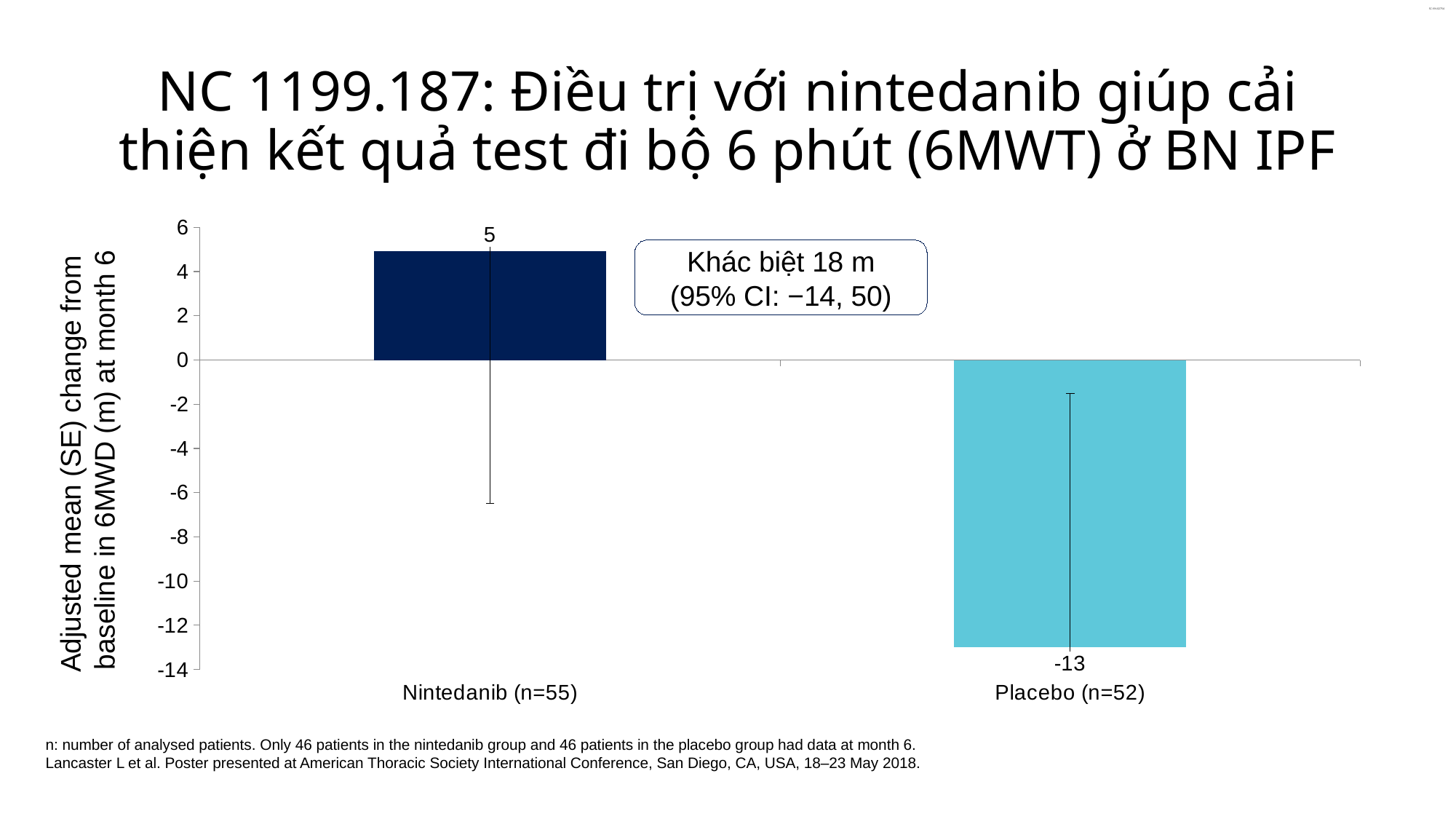
What is the difference between the Nintedanib value (5) and the Placebo value (-13)? 18 What is the adjusted mean change from baseline in 6MWD at month 6 for Nintedanib (n=55)? 5 What difference between groups is stated in the text box on the chart? 18 m (95% CI: −14, 50) Which group has the lowest adjusted mean change from baseline in 6MWD at month 6? Placebo (n=52) How many groups are plotted on the chart? 2 Is the value for Nintedanib (n=55) larger or smaller than the value for Placebo (n=52)? larger Is the value for Placebo (n=52) greater or less than -10? less What is the label of the y axis? Adjusted mean (SE) change from baseline in 6MWD (m) at month 6 Which group has the higher adjusted mean change from baseline in 6MWD at month 6? Nintedanib (n=55) What is the adjusted mean change from baseline in 6MWD at month 6 for Placebo (n=52)? -13 What kind of chart is shown on the slide? bar chart Is the value for Nintedanib (n=55) greater or less than 0? greater